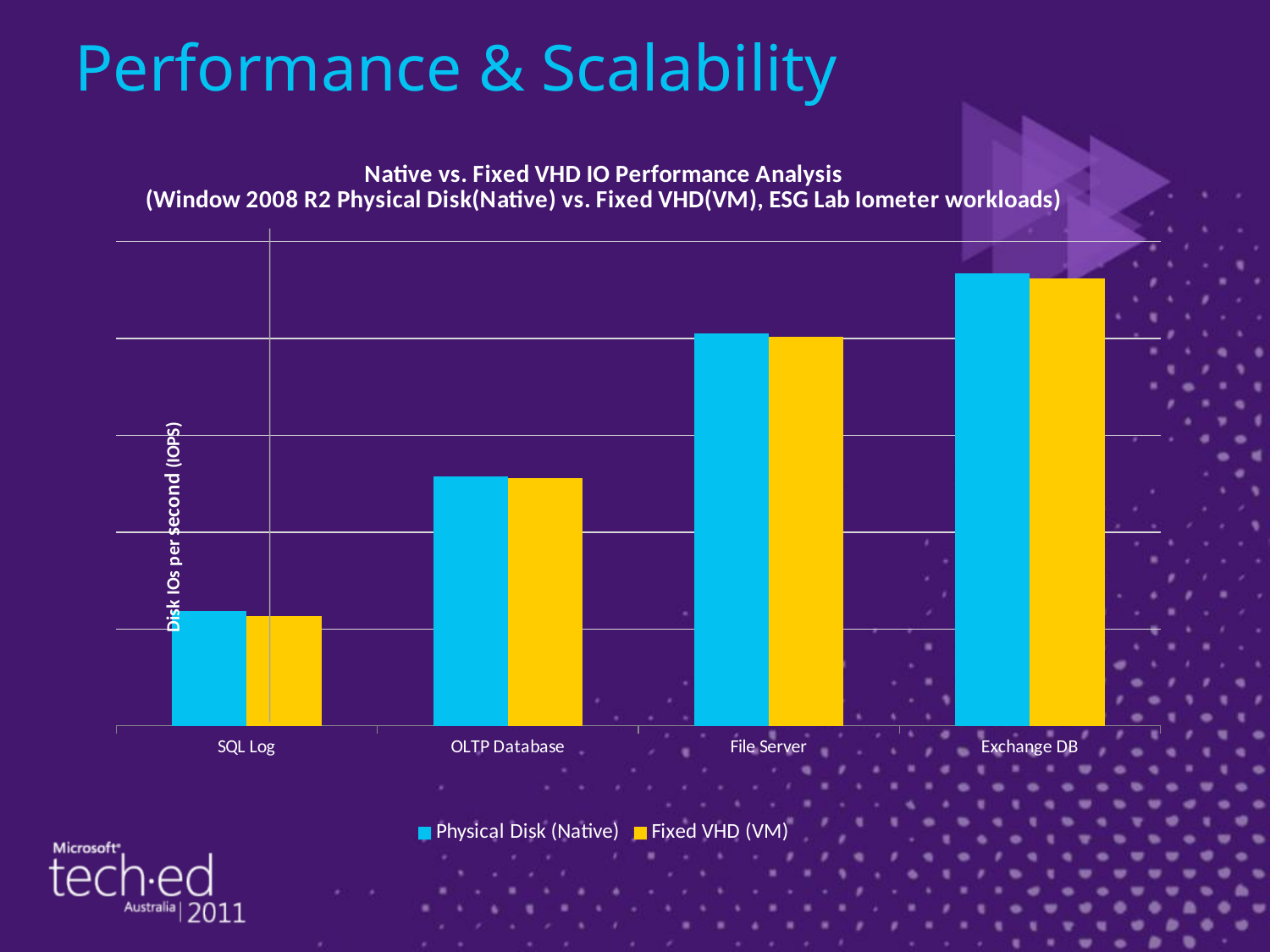
Which workload has the highest Physical Disk (Native) IOPS? Exchange DB Which series is shown in yellow in the legend? Fixed VHD (VM) How many series does the legend list? 2 What kind of chart is shown on the slide? Bar chart For Physical Disk (Native), which is larger: File Server or OLTP Database? File Server Do the IOPS values rise or fall moving from SQL Log to Exchange DB along the x axis? Rise What is the label on the vertical axis of the chart? Disk IOs per second (IOPS) Which workload has the lowest Fixed VHD (VM) IOPS? SQL Log For Fixed VHD (VM), which is larger: SQL Log or OLTP Database? OLTP Database Which workload has the lowest Physical Disk (Native) IOPS? SQL Log How many workload categories are shown on the x axis? 4 Which workload has the highest Fixed VHD (VM) IOPS? Exchange DB